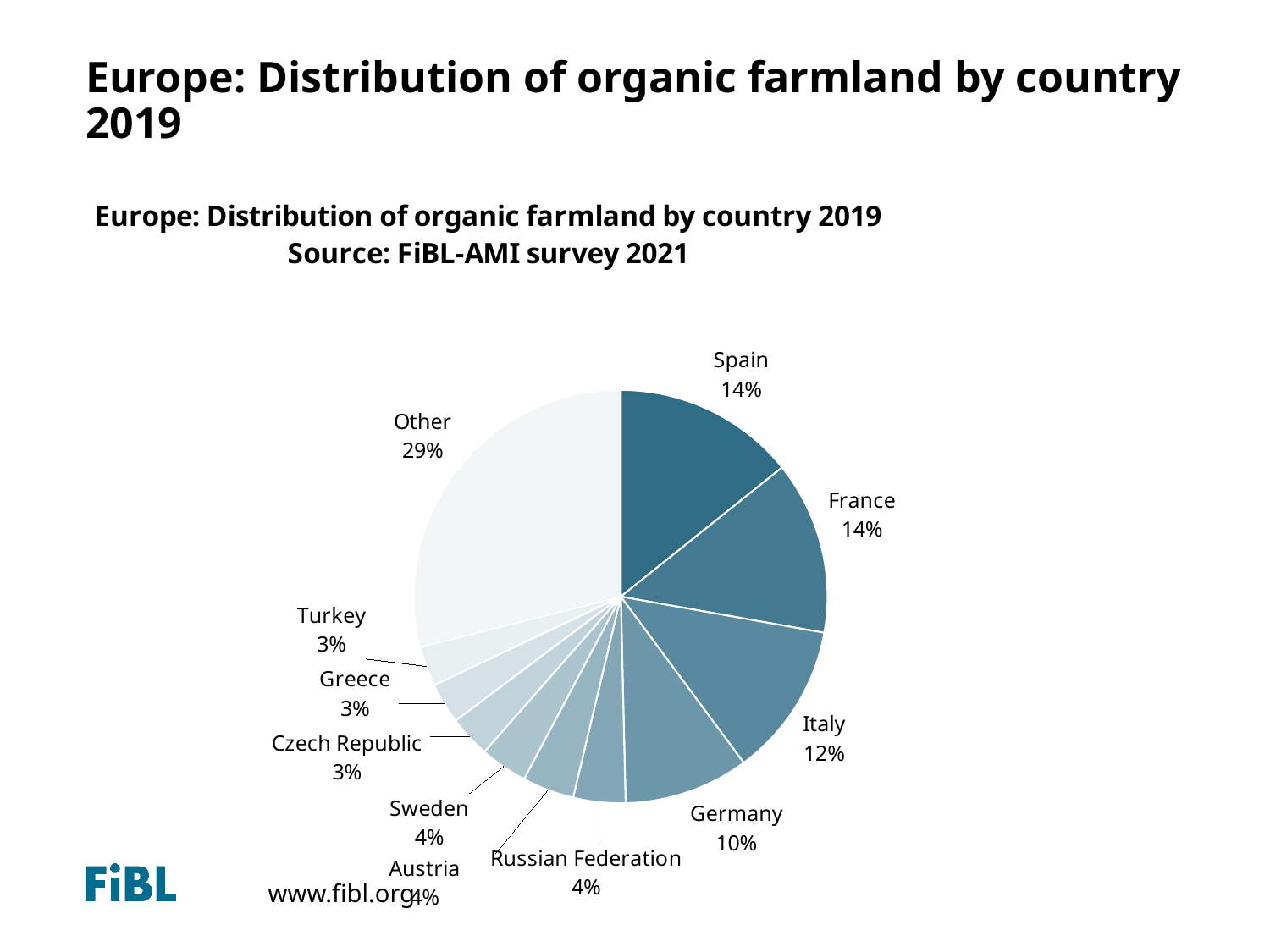
What is the difference in percentage points between the Other slice and Germany? 19% How many slices does the pie chart have? 11 Which slice of the pie chart is the largest? Other What share of organic farmland does Spain account for in the pie chart? 14% Which has a larger share, Italy or Germany? Italy What kind of chart is shown on the slide? Pie chart What share is shown for the Russian Federation? 4% What is the difference in percentage points between Spain and Italy? 2% What percentage is shown for Italy? 12% Which has a larger share, Germany or Sweden? Germany What source is cited for the chart? FiBL-AMI survey 2021 What percentage is shown for the Czech Republic? 3%